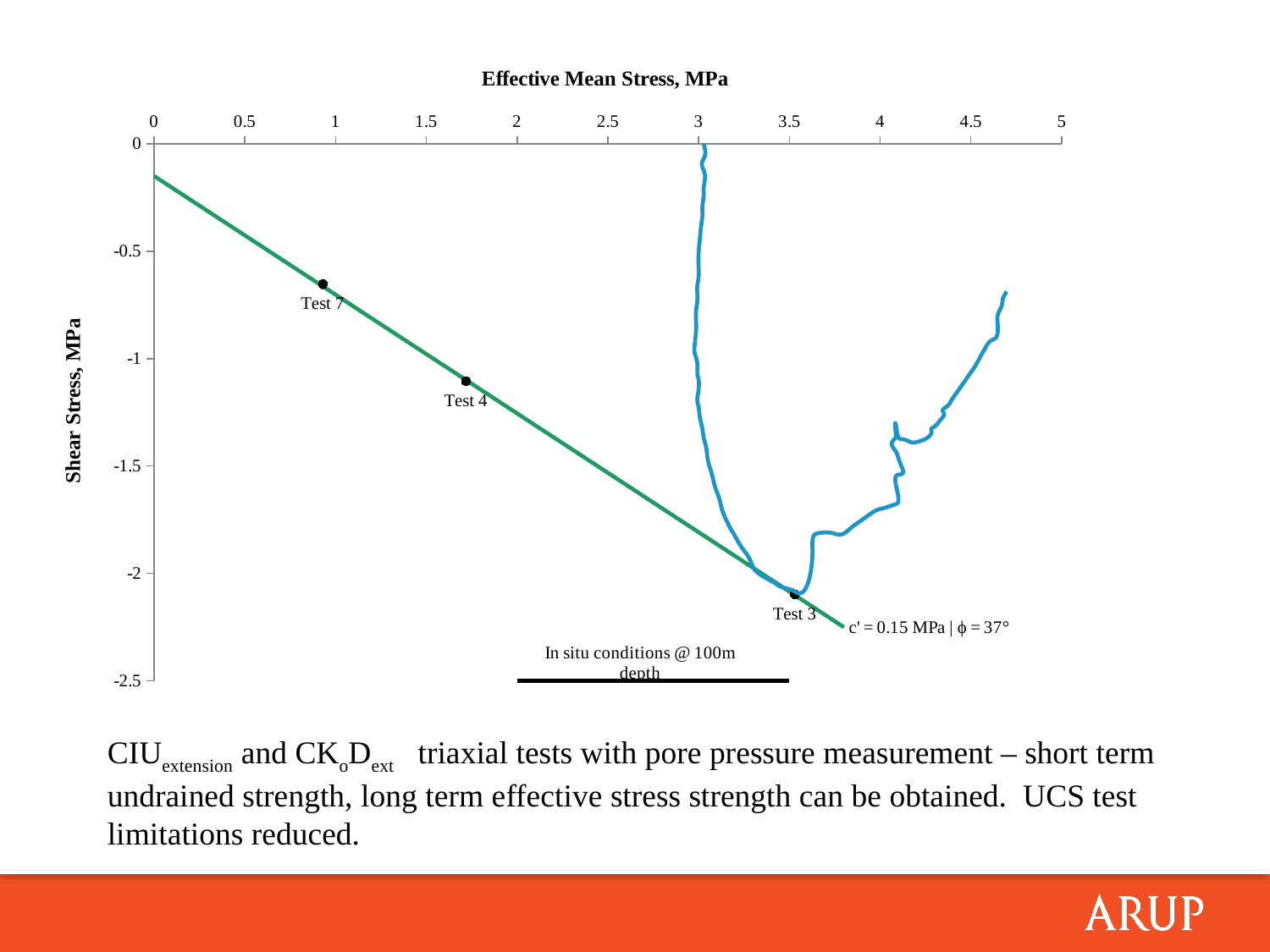
Is the effective mean stress for Test 7 greater or less than 1 MPa? less What is the title of the vertical axis of the chart? Shear Stress, MPa What is the title of the horizontal axis of the chart? Effective Mean Stress, MPa Is the shear stress for Test 3 greater or less than -2 MPa? less Is the effective mean stress for Test 4 greater or less than 1.5 MPa? greater Which has the larger effective mean stress, Test 4 or Test 7? Test 4 Which labelled test point has the lowest effective mean stress? Test 7 Which labelled test point has the most negative shear stress? Test 3 How many labelled test points are plotted on the chart? 3 Does the green failure envelope line rise or fall as effective mean stress increases? fall Which labelled test point has the highest effective mean stress? Test 3